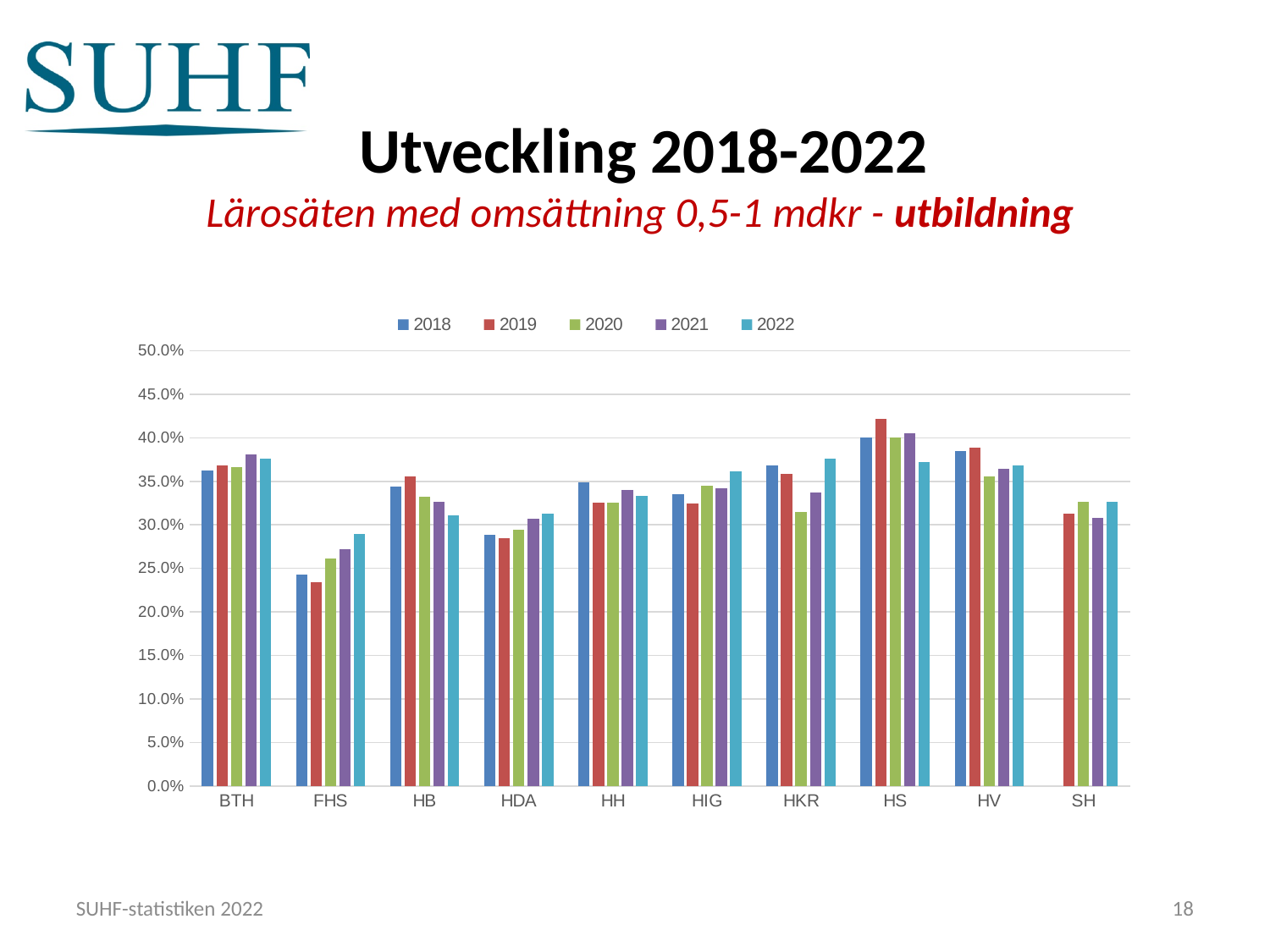
Which institution has the highest bar in the chart? HS Which is larger, the 2022 value for BTH or the 2022 value for FHS? BTH Is the value for BTH in 2021 greater or less than 35.0%? greater Is the value for HDA in 2019 greater or less than 30.0%? less Which institution has the lowest bar in the chart? FHS How many series does the legend list? 5 Is the value for HS in 2019 greater or less than 40.0%? greater How many categories (institutions) are shown on the x axis? 10 What kind of chart is shown on the slide? bar chart For FHS, do the values rise or fall from 2020 to 2022? rise Which year is shown in red in the legend? 2019